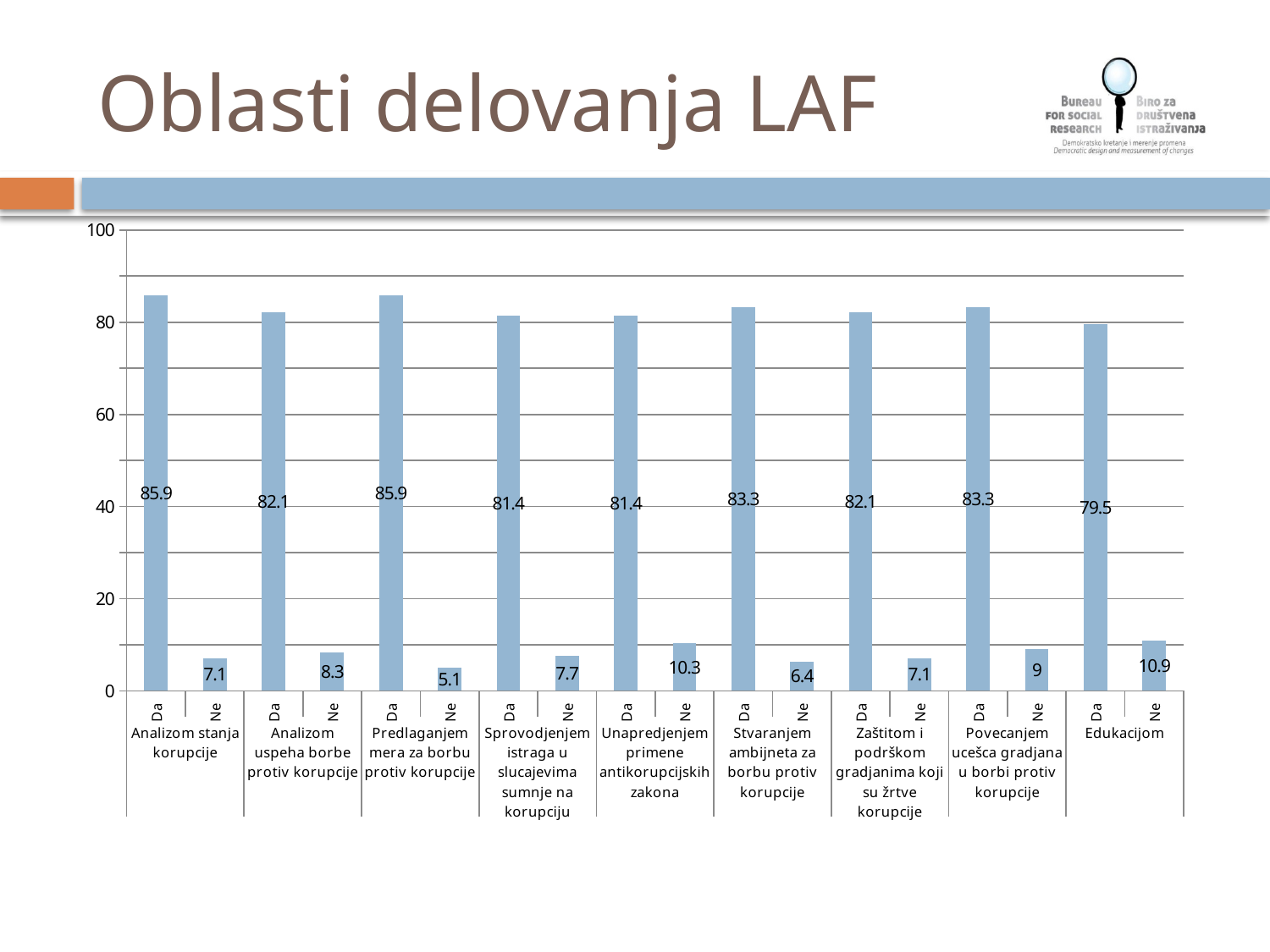
What type of chart is shown on the slide? Bar chart Which category has the lowest "Da" value? Edukacijom What is the value of the "Ne" bar for "Unapredjenjem primene antikorupcijskih zakona"? 10.3 What is the value of the "Da" bar for "Edukacijom"? 79.5 What is the value of the "Da" bar for "Stvaranjem ambijneta za borbu protiv korupcije"? 83.3 How many categories (areas of activity) are shown on the x axis of the chart? 9 What is the difference between the "Da" and "Ne" values for "Edukacijom"? 68.6 What is the value of the "Ne" bar for "Analizom stanja korupcije"? 7.1 Which category has the lowest "Ne" value? Predlaganjem mera za borbu protiv korupcije Which category has the highest "Ne" value? Edukacijom Which is larger: the "Ne" value for "Povecanjem ucešca gradjana u borbi protiv korupcije" or the "Ne" value for "Stvaranjem ambijneta za borbu protiv korupcije"? Povecanjem ucešca gradjana u borbi protiv korupcije Is the "Da" value for "Analizom stanja korupcije" greater or less than 80? greater